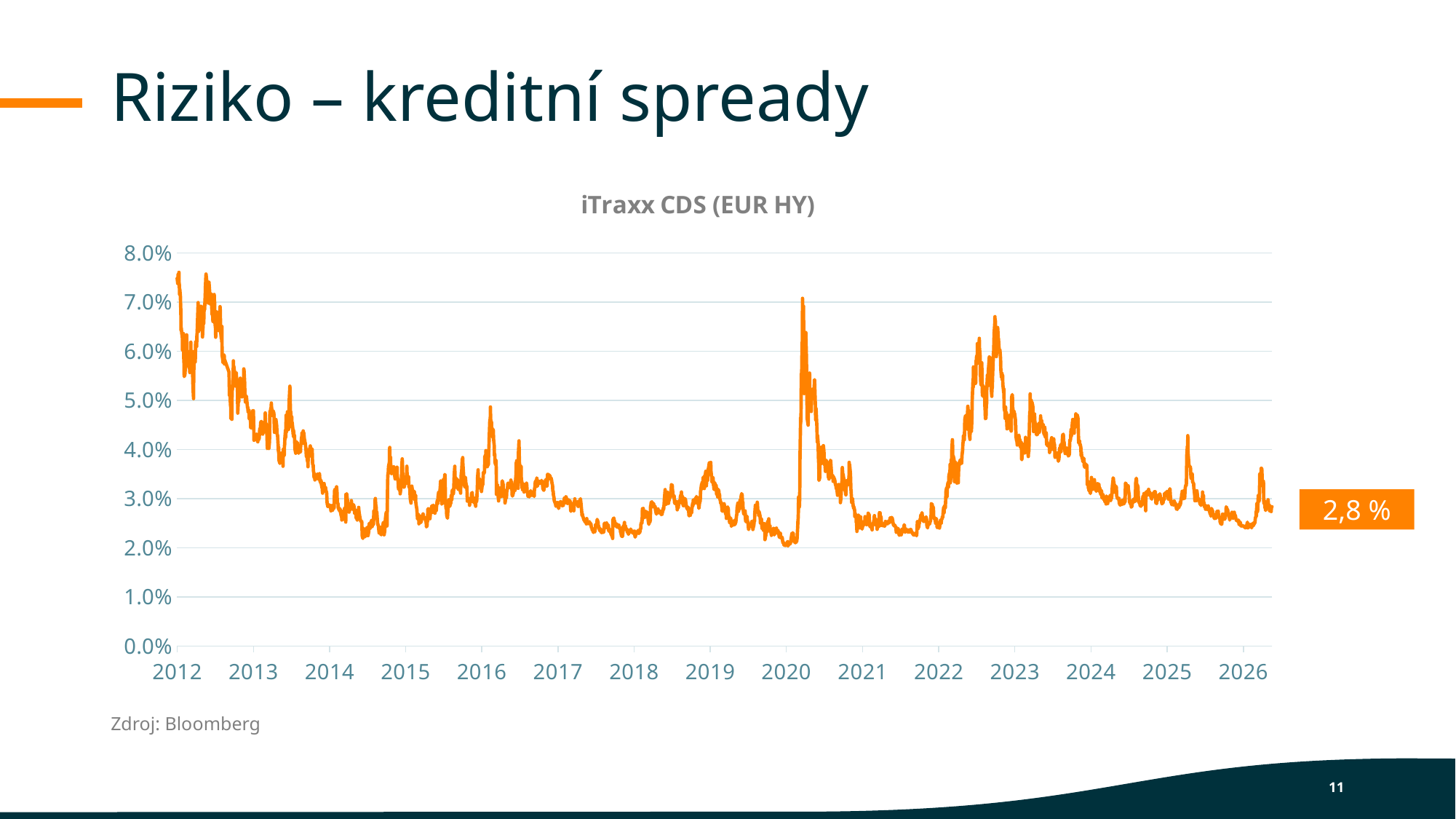
How many year labels are shown on the x axis? 15 Is the value of the iTraxx CDS (EUR HY) at the start of 2018 greater or less than 3.0%? less What kind of chart is shown on the slide? line chart Is the value of the iTraxx CDS (EUR HY) at the start of 2012 greater or less than 7.0%? greater What is the title of the chart? iTraxx CDS (EUR HY) Is the peak value of the iTraxx CDS (EUR HY) in 2020 greater or less than 6.0%? greater What is the most recent value of the iTraxx CDS (EUR HY) series, as labelled at the end of the line? 2,8 % Which is higher: the iTraxx CDS (EUR HY) at the start of 2012 or at the start of 2026? start of 2012 Overall, does the iTraxx CDS (EUR HY) rise or fall between 2012 and 2026? fall What is the highest value shown on the y axis? 8.0% How many lines are plotted on the chart? 1